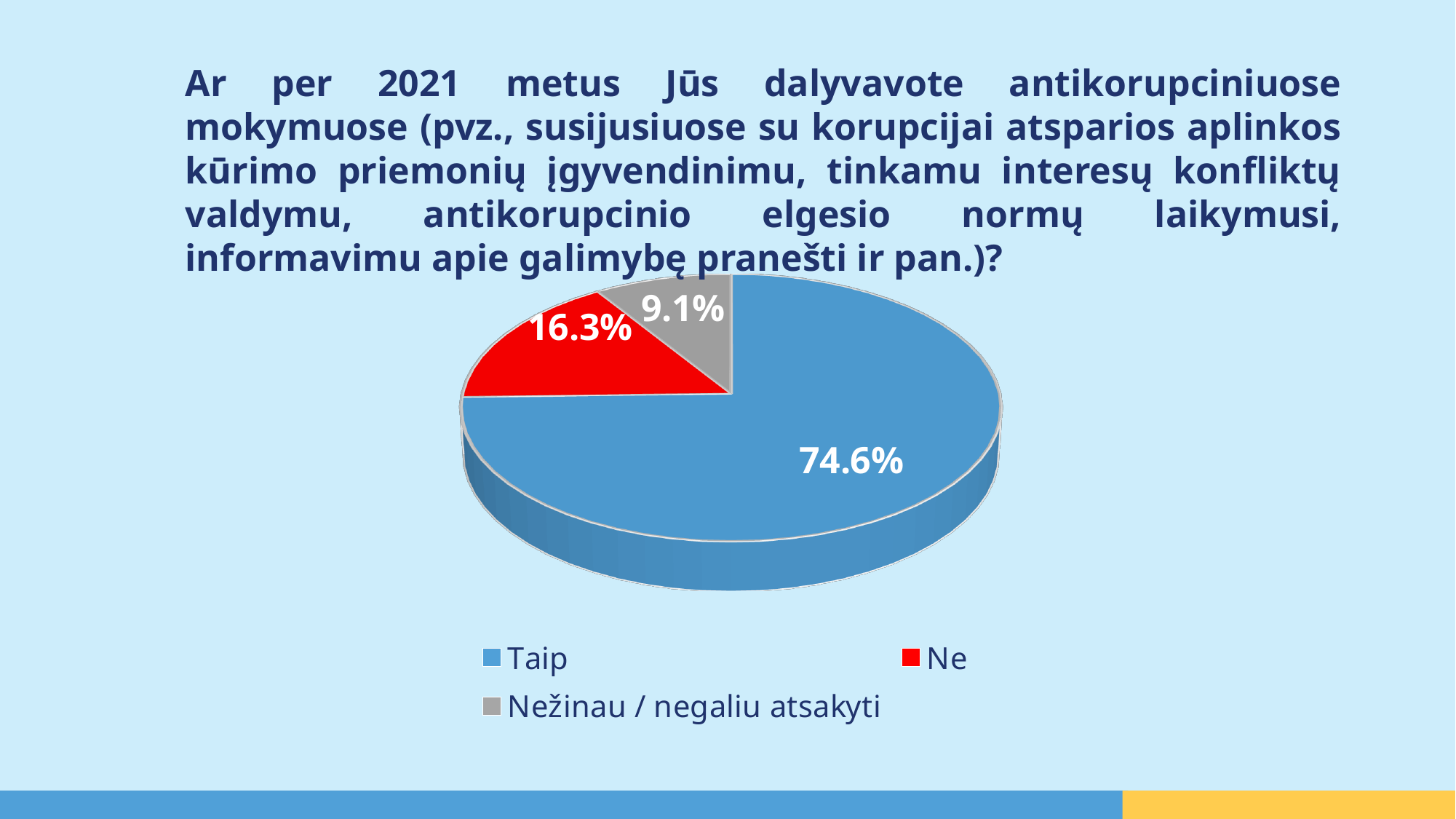
What percentage of respondents answered "Ne"? 16.3% What is the difference in percentage points between the "Taip" and "Ne" slices? 58.3 How many slices does the pie chart have? 3 What percentage of respondents answered "Taip"? 74.6% Which is larger, the "Ne" slice or the "Nežinau / negaliu atsakyti" slice? Ne What colour is the "Ne" slice? Red What percentage of respondents answered "Nežinau / negaliu atsakyti"? 9.1% How many entries does the legend list? 3 Which answer has the largest share of the pie? Taip What is the difference in percentage points between the "Ne" and "Nežinau / negaliu atsakyti" slices? 7.2 Which answer has the smallest share of the pie? Nežinau / negaliu atsakyti What kind of chart is shown on the slide? Pie chart